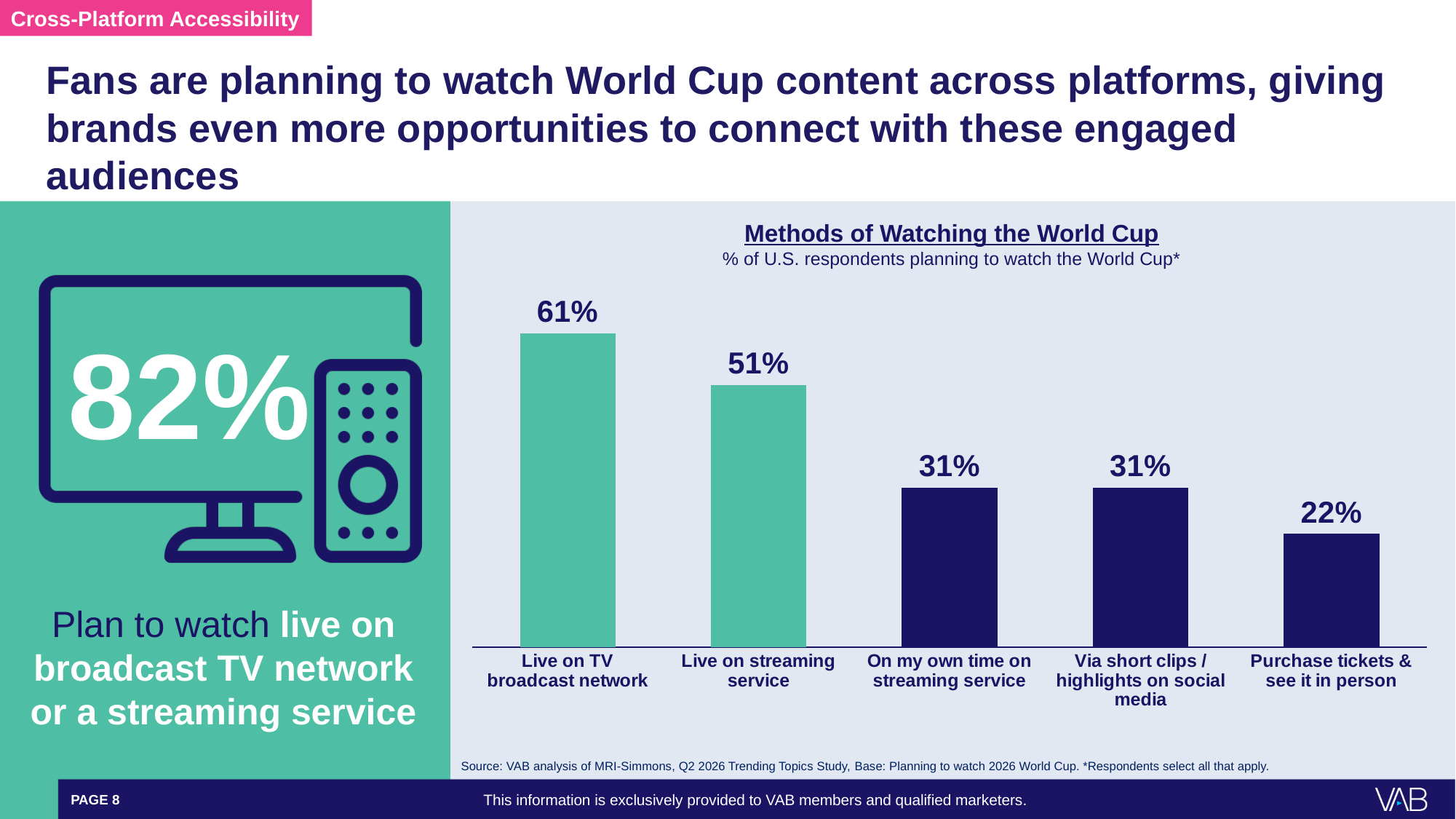
What is the difference between 'Live on TV broadcast network' and 'Live on streaming service'? 10% What percentage of respondents plan to watch the World Cup live on a TV broadcast network? 61% What is the value for 'Purchase tickets & see it in person'? 22% What is the title of the chart? Methods of Watching the World Cup What percentage plan to watch on their own time on a streaming service? 31% What is the difference between 'Via short clips / highlights on social media' and 'Purchase tickets & see it in person'? 9% What type of chart is used to show the methods of watching the World Cup? Bar chart How many methods of watching the World Cup are shown in the chart? 5 What is the value for 'Live on streaming service'? 51% Which is larger: 'Live on streaming service' or 'On my own time on streaming service'? Live on streaming service Which method of watching the World Cup has the highest percentage? Live on TV broadcast network Which method of watching the World Cup has the lowest percentage? Purchase tickets & see it in person